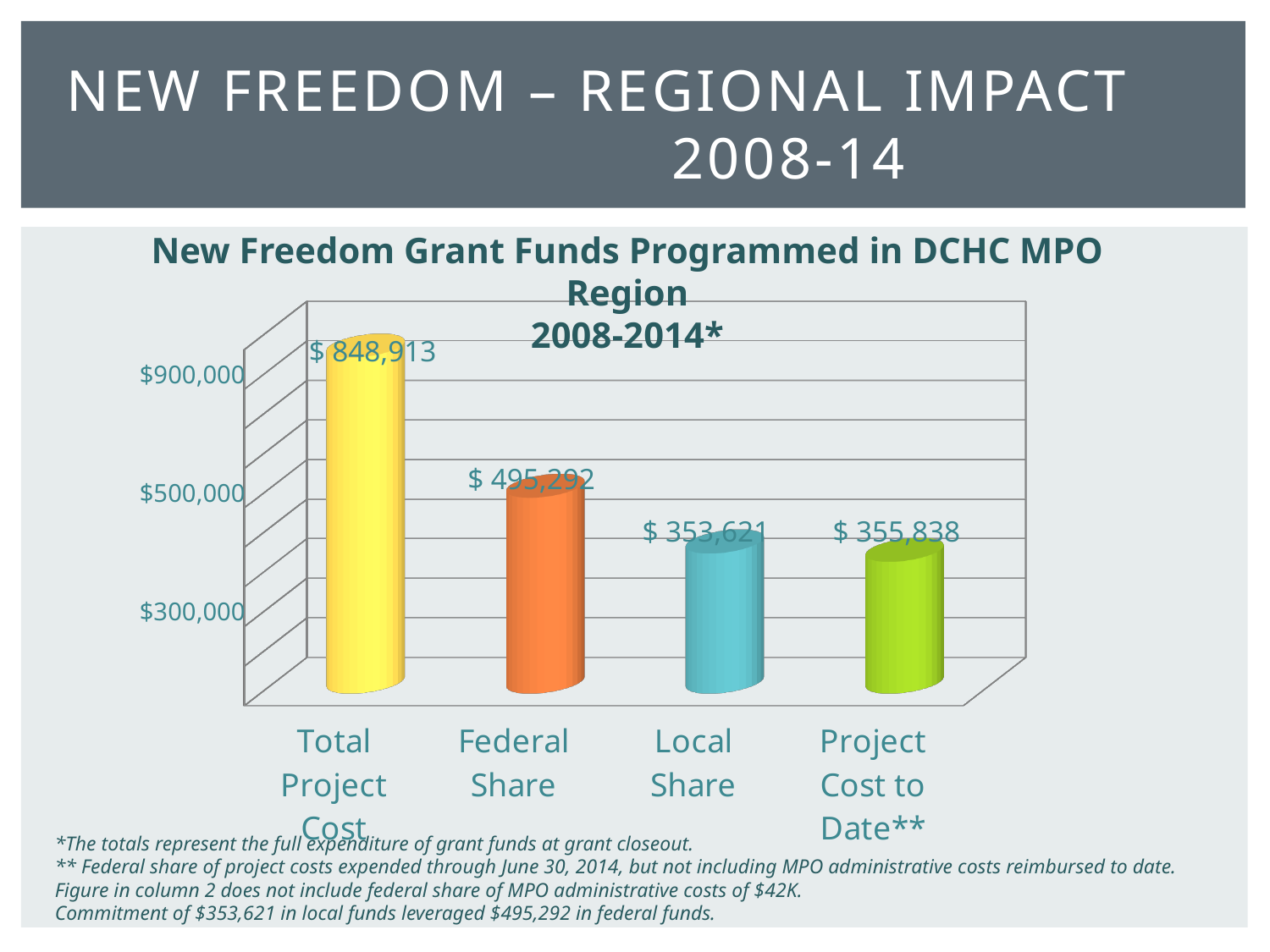
What is the value for Local Share? $ 353,621 What is the value for Federal Share? $ 495,292 What is the value for Project Cost to Date**? $ 355,838 Is the value for Local Share greater or less than $500,000? less What is the difference between Total Project Cost and Federal Share? $ 353,621 What is the value for Total Project Cost? $ 848,913 What is the difference between Federal Share and Local Share? $ 141,671 What is the difference between Project Cost to Date** and Local Share? $ 2,217 How many categories are shown in the chart? 4 Which is larger, Federal Share or Local Share? Federal Share Which category has the highest value? Total Project Cost What kind of chart is shown on the slide? bar chart